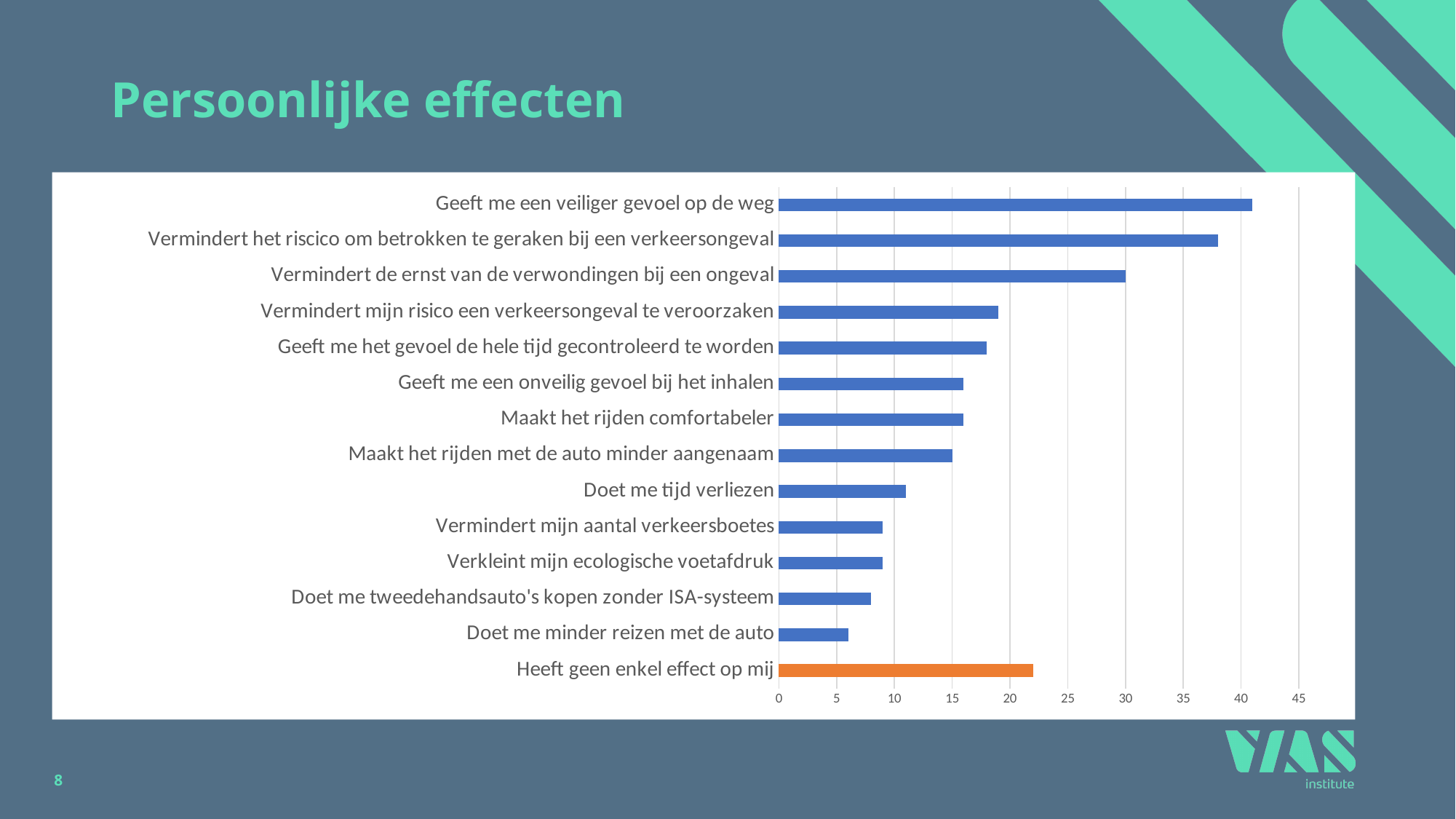
Which category has the highest value? Geeft me een veiliger gevoel op de weg What kind of chart is shown on the slide? bar chart Is the value for 'Doet me tijd verliezen' greater or less than 15? less Which category is shown with an orange bar instead of a blue one? Heeft geen enkel effect op mij Is the value for 'Doet me minder reizen met de auto' greater or less than 10? less How many categories are plotted in the chart? 14 Which is larger: the value for 'Vermindert de ernst van de verwondingen bij een ongeval' or the value for 'Vermindert mijn risico een verkeersongeval te veroorzaken'? Vermindert de ernst van de verwondingen bij een ongeval Which is larger: the value for 'Heeft geen enkel effect op mij' or the value for 'Doet me tijd verliezen'? Heeft geen enkel effect op mij Which category has the lowest value? Doet me minder reizen met de auto Is the value for 'Vermindert het riscico om betrokken te geraken bij een verkeersongeval' greater or less than 35? greater